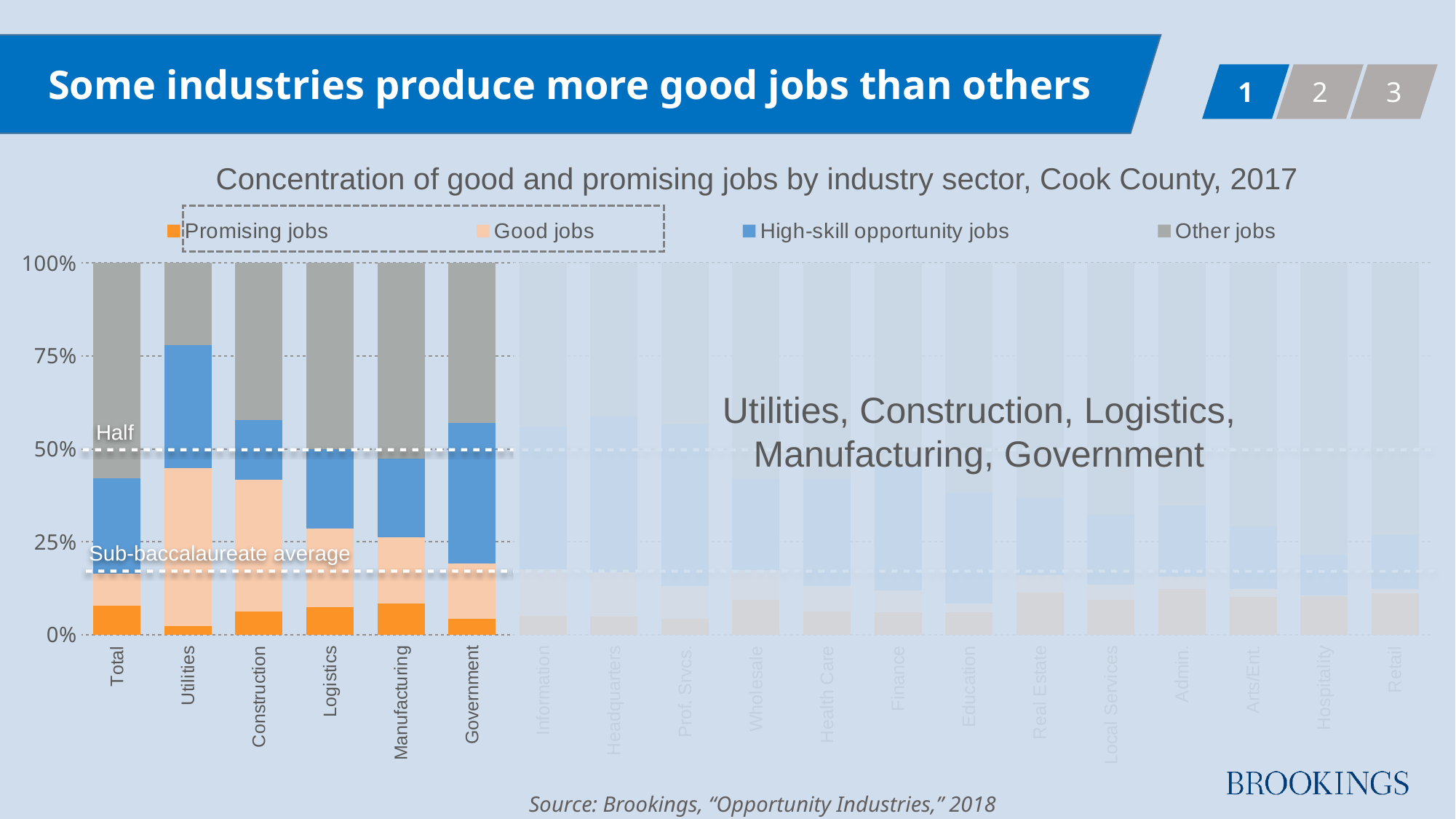
How many series does the chart legend list? 4 Is the Other jobs share for Total greater or less than 50%? greater Which legend entry is shown in orange? Promising jobs What is the title of the chart? Concentration of good and promising jobs by industry sector, Cook County, 2017 Is the Good jobs share for Utilities greater or less than 25%? greater Is the Good jobs share for Construction greater or less than 25%? greater Which has the larger Good jobs share, Utilities or Government? Utilities Among the highlighted bars (Total, Utilities, Construction, Logistics, Manufacturing, Government), which has the largest Good jobs segment? Utilities How many industry categories are shown along the x axis of the chart? 19 What kind of chart is shown on the slide? Stacked bar chart